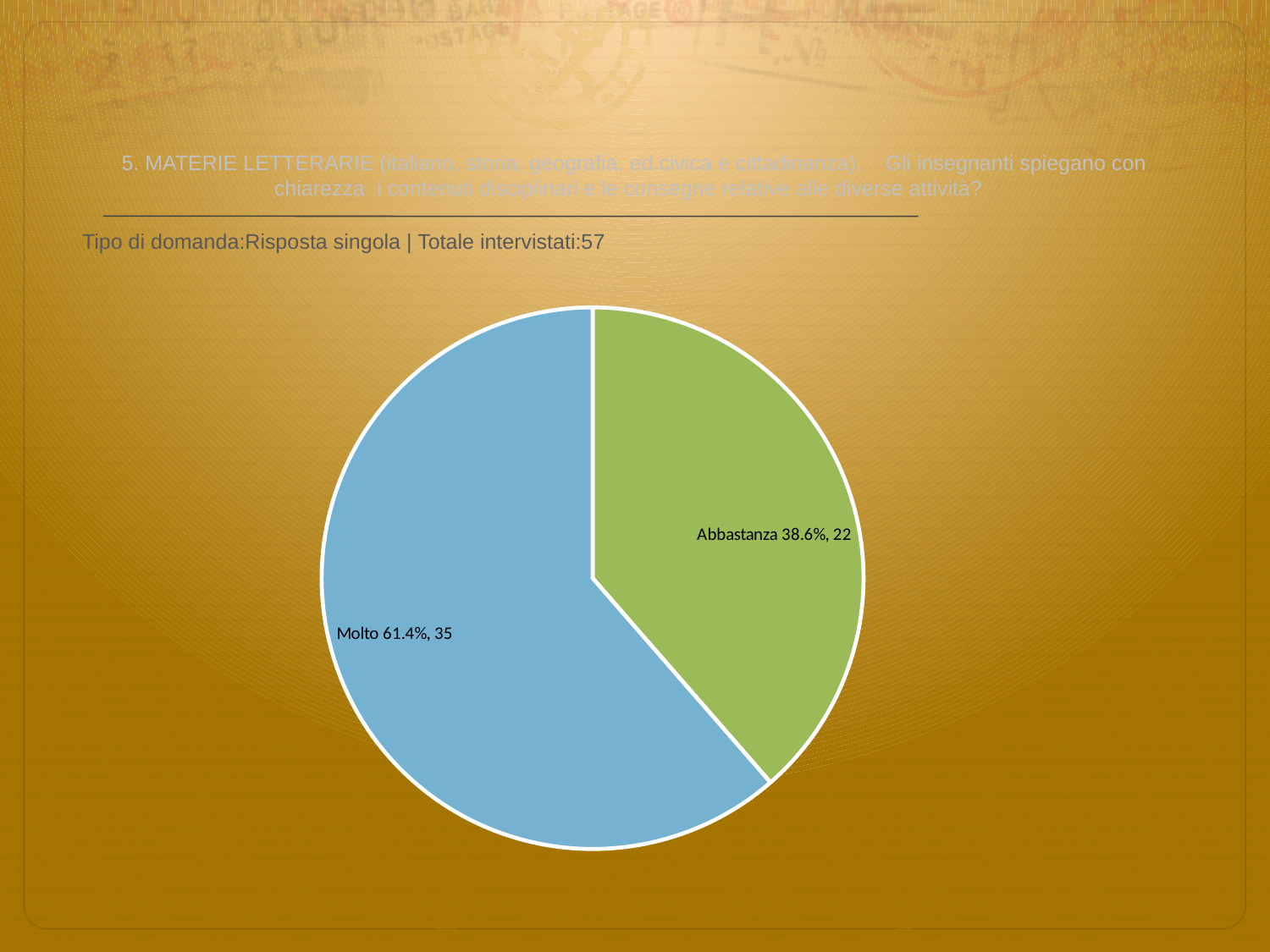
What is the difference in respondent count between Molto and Abbastanza? 13 Which slice is the largest in the pie chart? Molto How many respondents answered Molto? 35 What percentage share does the Abbastanza slice have? 38.6% What percentage share does the Molto slice have? 61.4% What is the total number of respondents shown in the pie chart? 57 How many respondents answered Abbastanza? 22 Which slice is the smallest in the pie chart? Abbastanza What kind of chart is shown on the slide? pie chart How many slices does the pie chart have? 2 What colour is the Molto slice? blue Which has more respondents, Molto or Abbastanza? Molto